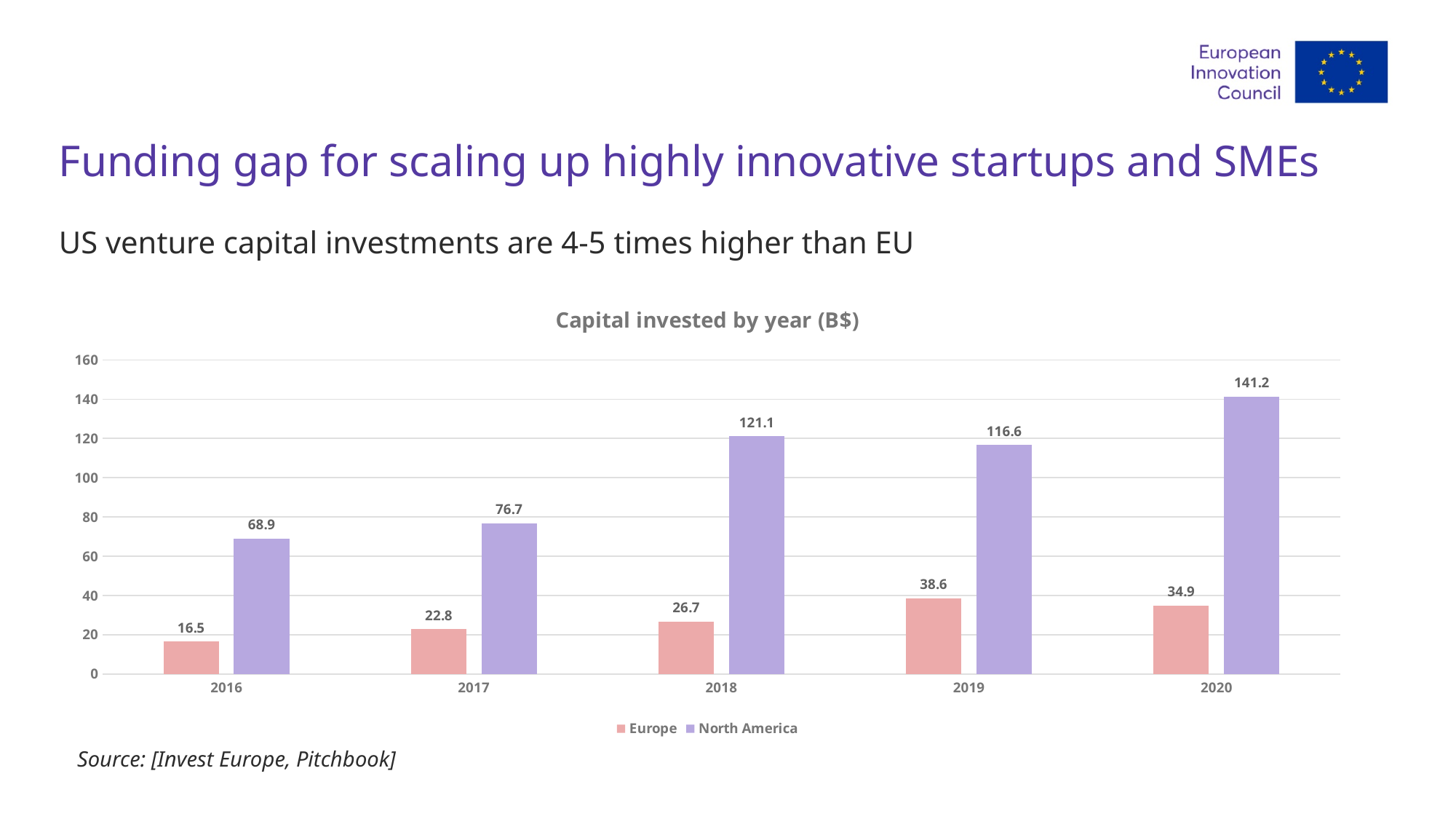
What is the value for Europe in 2016? 16.5 How many years are shown on the x axis? 5 In which year is the North America value highest? 2020 How many series does the legend list? 2 In which year is the Europe value lowest? 2016 Is the value for North America in 2017 greater or less than 80? less What kind of chart is shown on the slide? Bar chart What is the difference between the North America and Europe values in 2018? 94.4 Which is larger, the Europe value in 2019 or the Europe value in 2020? Europe in 2019 What is the value for Europe in 2019? 38.6 What is the value for North America in 2020? 141.2 What is the title of the chart? Capital invested by year (B$)